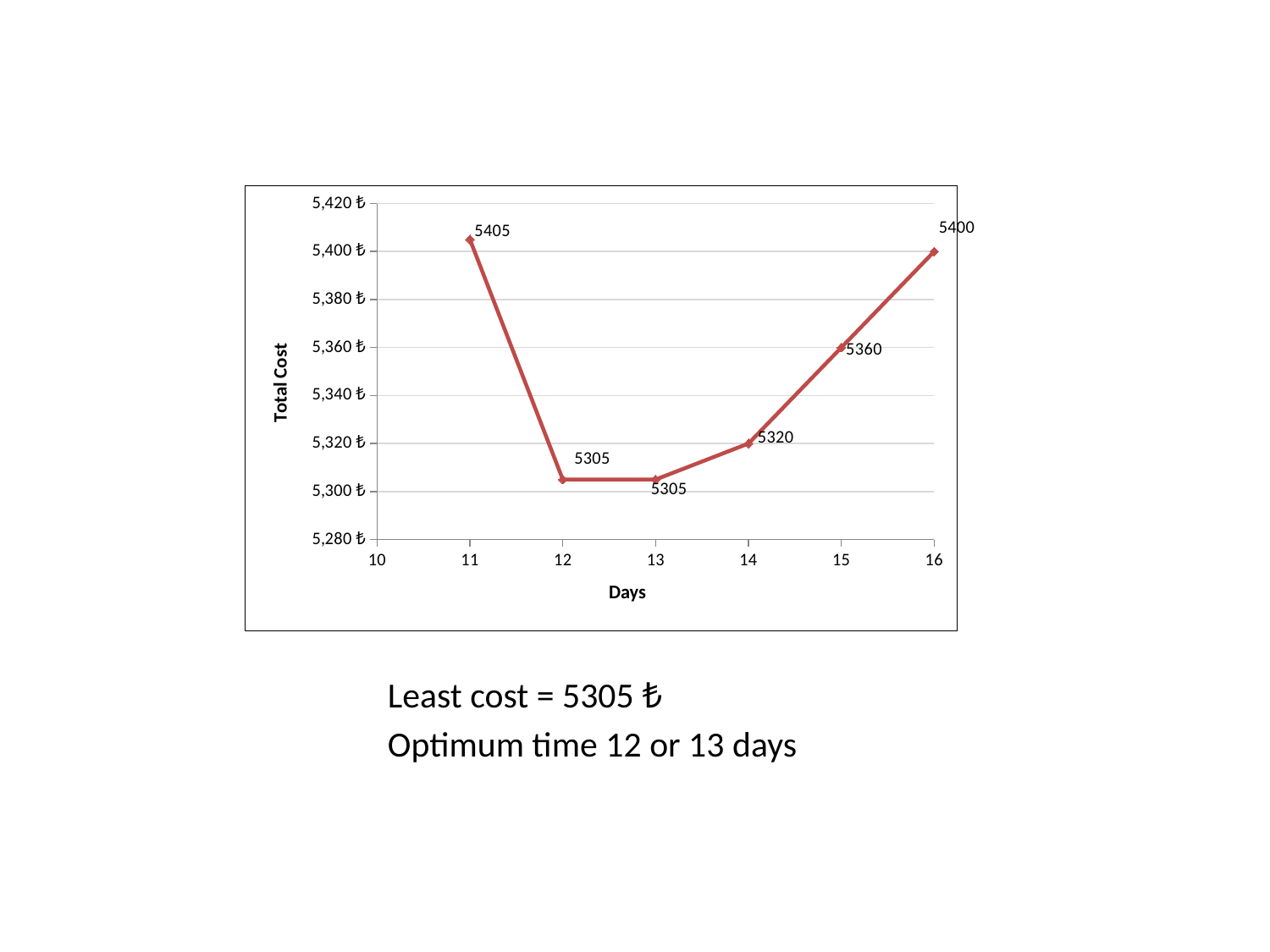
How many data points are plotted on the chart? 6 What is the total cost at 14 days? 5320 At which number of days is the total cost highest? 11 What kind of chart is shown on the slide? line chart What is the label of the vertical axis? Total Cost Which has a higher total cost, 11 days or 16 days? 11 days What is the lowest total cost plotted on the chart? 5305 What is the difference in total cost between 16 days and 15 days? 40 What is the total cost at 11 days? 5405 What is the total cost at 16 days? 5400 What is the difference in total cost between 11 days and 12 days? 100 What is the total cost at 15 days? 5360